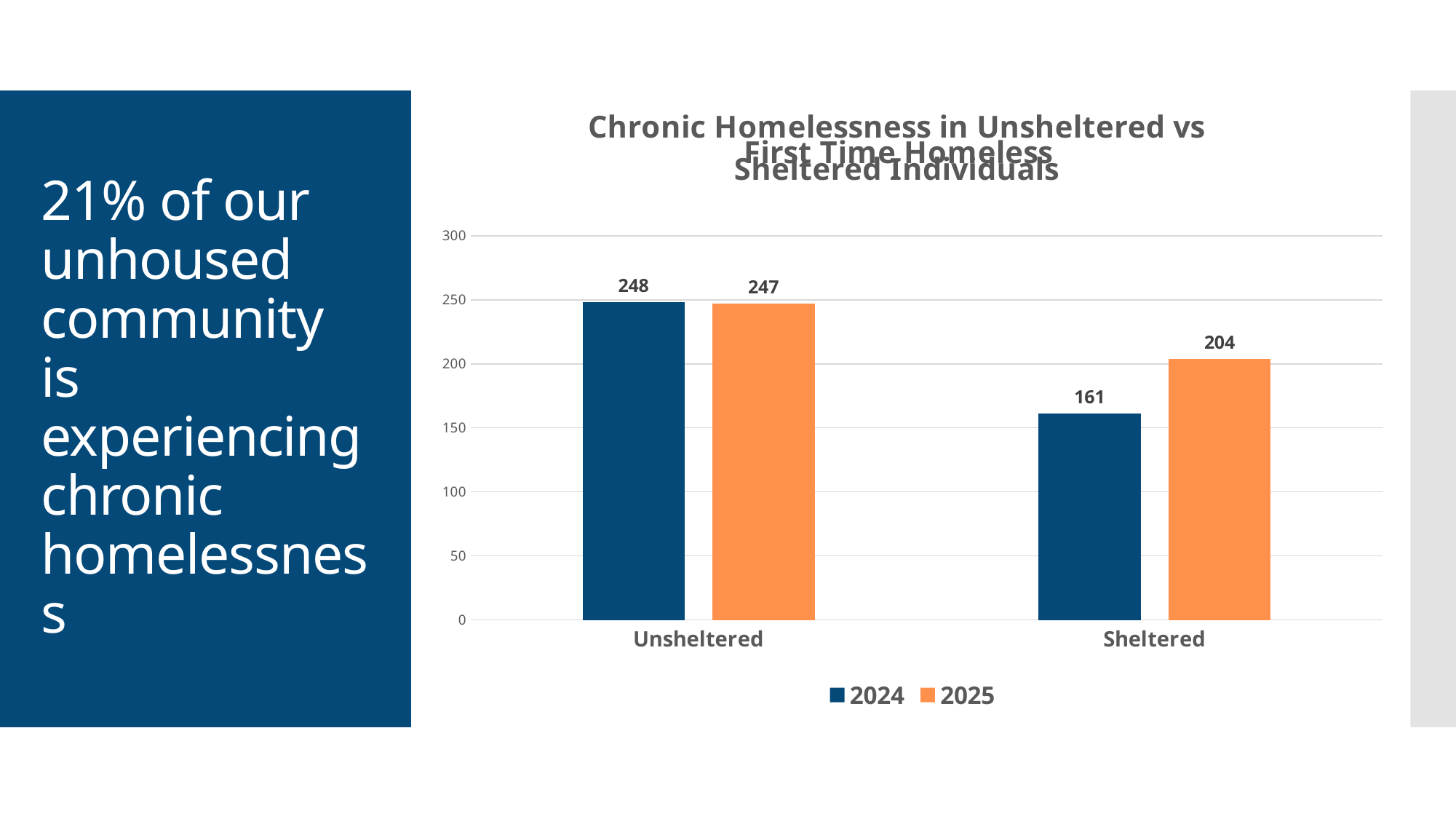
How many categories are shown on the x axis? 2 What is the value for Sheltered in 2025? 204 Which is larger for Sheltered, the 2024 value or the 2025 value? 2025 What is the difference between the Unsheltered and Sheltered values in 2024? 87 Which category has the lowest value in 2024? Sheltered Which category has the highest value in 2025? Unsheltered What kind of chart is shown on the slide? Bar chart What is the value for Unsheltered in 2025? 247 How many series does the legend list? 2 What is the value for Unsheltered in 2024? 248 What is the difference between the 2025 and 2024 values for Sheltered? 43 What is the value for Sheltered in 2024? 161